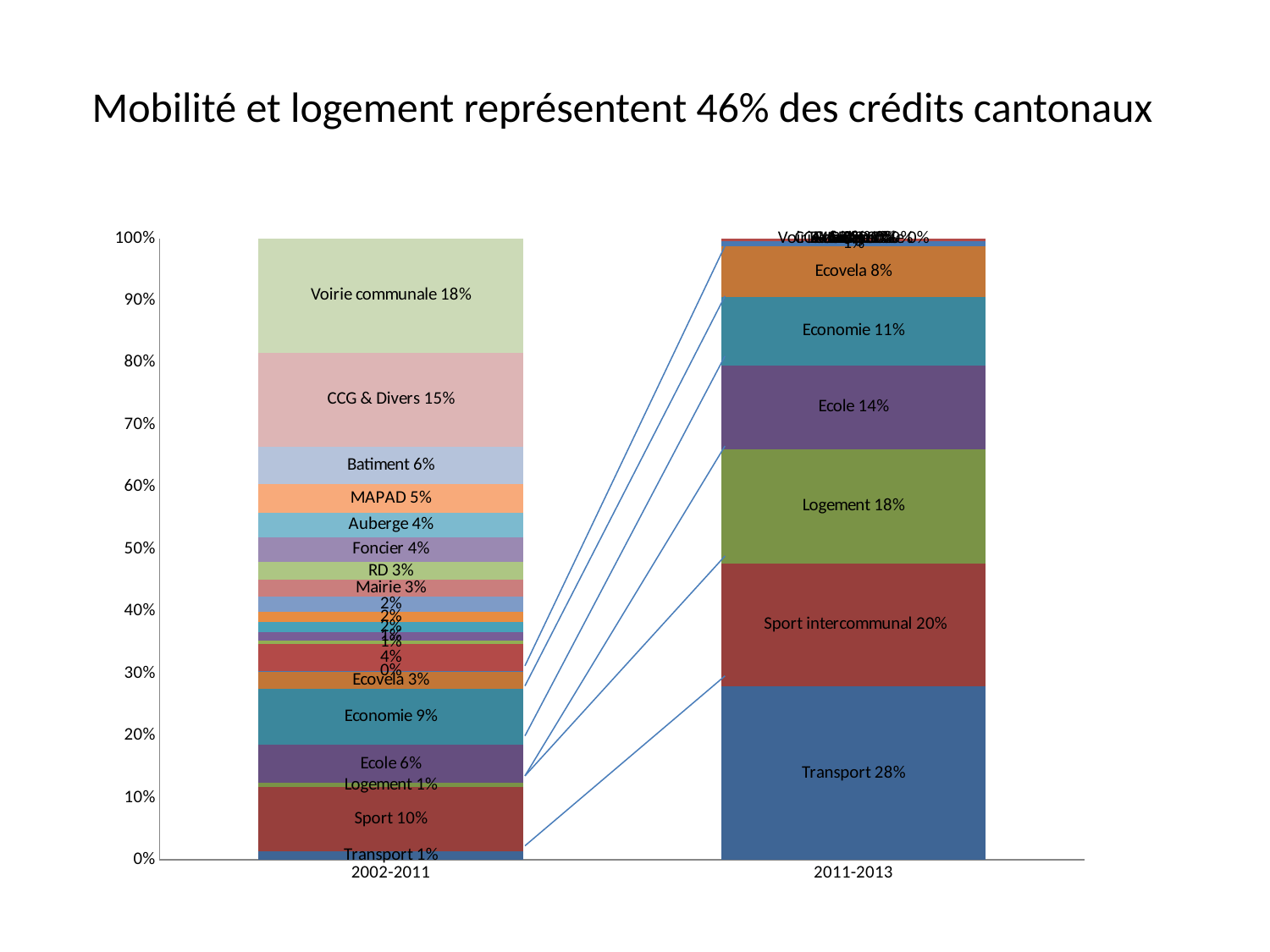
By how many percentage points does the Ecole share in 2011-2013 exceed the Ecole share in 2002-2011? 8 Which segment is the largest in the 2002-2011 bar? Voirie communale 18% What kind of chart is shown on the slide? stacked bar chart What is the title of the slide? Mobilité et logement représentent 46% des crédits cantonaux Which is larger: the Logement share in 2002-2011 or in 2011-2013? 2011-2013 What share does Sport intercommunal represent in the 2011-2013 bar? 20% How many periods (categories) are shown on the x axis? 2 What share does Transport represent in the 2011-2013 bar? 28% What share does Voirie communale represent in the 2002-2011 bar? 18% What share does Economie represent in the 2002-2011 bar? 9% Which segment is the largest in the 2011-2013 bar? Transport 28% What share does Logement represent in the 2011-2013 bar? 18%